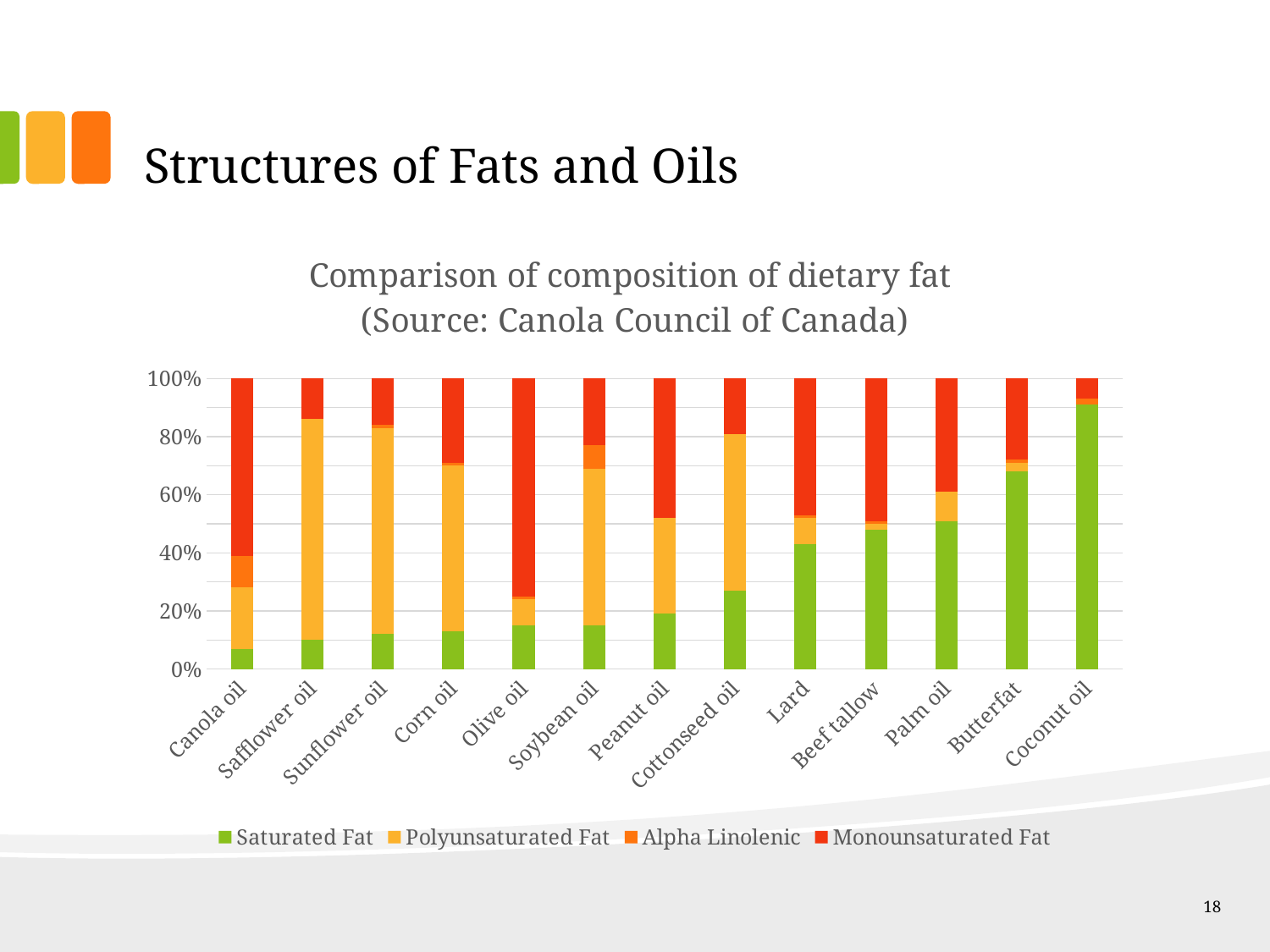
Which fat or oil has the highest share of Saturated Fat? Coconut oil Which has a larger share of Polyunsaturated Fat, Safflower oil or Canola oil? Safflower oil Is the Saturated Fat share for Coconut oil greater or less than 80%? greater Which fat or oil has the lowest share of Saturated Fat? Canola oil Is the Saturated Fat share for Butterfat greater or less than 60%? greater What is the title of the chart? Comparison of composition of dietary fat (Source: Canola Council of Canada) How many fats and oils are shown along the x axis of the chart? 13 Is the Saturated Fat share for Canola oil greater or less than 20%? less How many series does the chart's legend list? 4 Which has a larger share of Monounsaturated Fat, Olive oil or Corn oil? Olive oil What kind of chart is shown on the slide? Stacked bar chart Which fat or oil has the highest share of Monounsaturated Fat? Olive oil